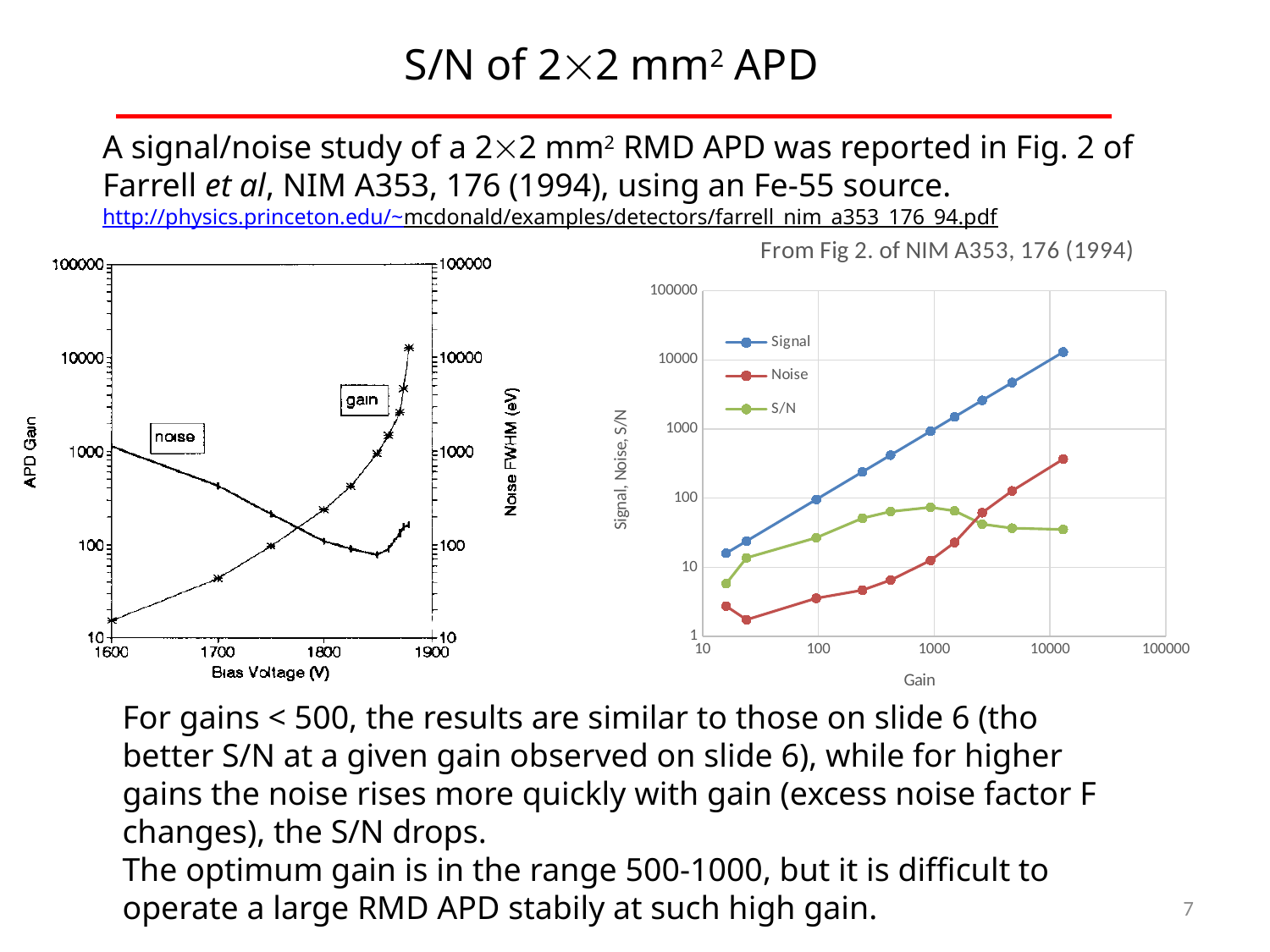
In the left chart, is the APD Gain at 1600 V greater or less than 100? less In the right chart, which series reaches the highest value? Signal In the left chart, does the gain curve rise or fall as Bias Voltage increases? rise What kind of chart is the right chart on the slide? line chart In the right chart, is the highest S/N value greater or less than 100? less In the right chart, at a gain of about 1000, which is larger, Signal or Noise? Signal In the right chart, is the highest Signal value greater or less than 10000? greater In the right chart (From Fig 2. of NIM A353, 176 (1994)), how many series does the legend list? 3 In the right chart, does the Signal series rise or fall as Gain increases? rise In the right chart, what is the label of the x axis? Gain In the right chart, what are the names of the series in the legend? Signal, Noise, S/N